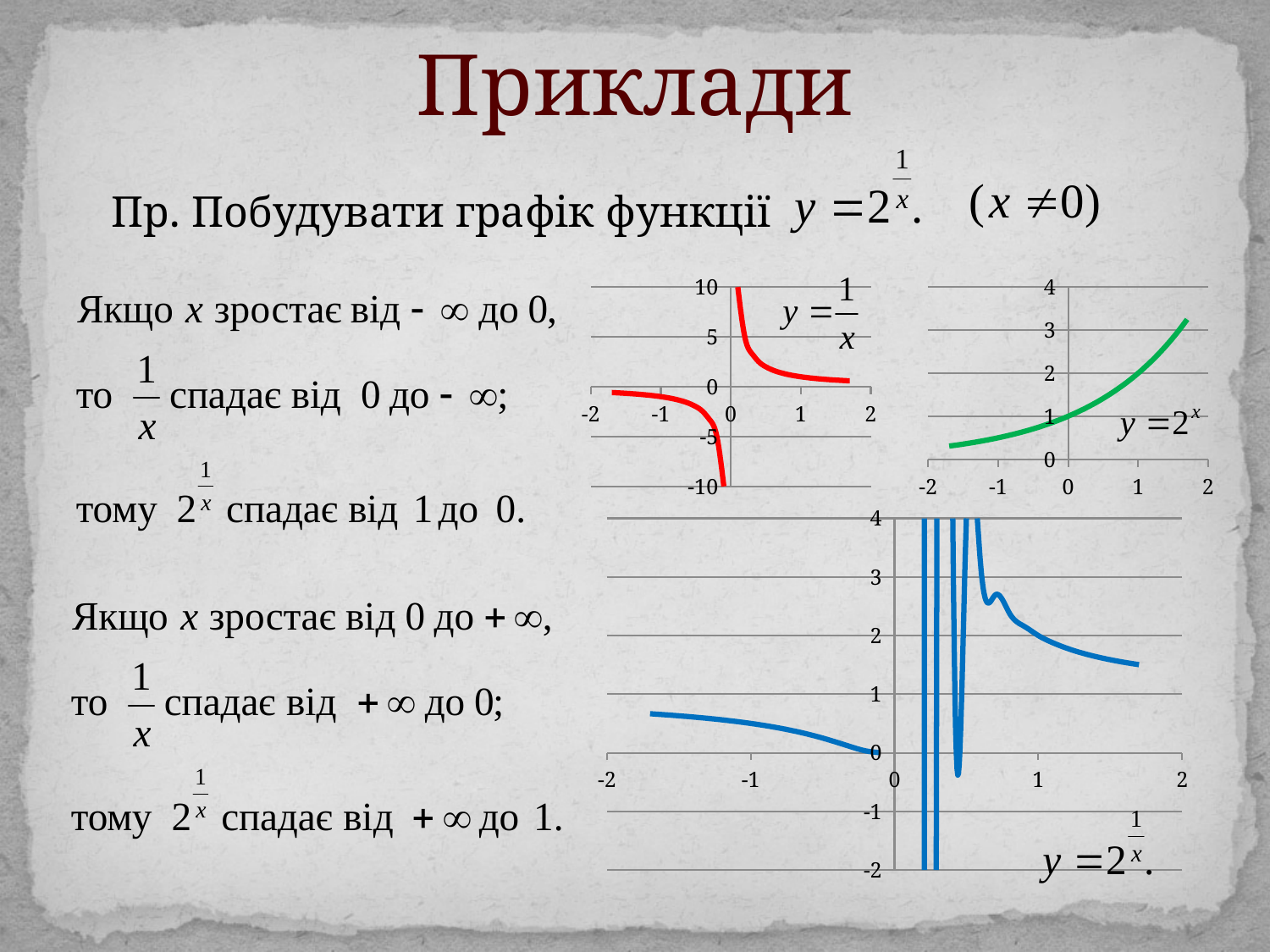
In the top-left chart y = 1/x, is the value at x = 1 greater or less than 5? less What kind of chart is the top-left chart labelled y = 1/x? line chart What colour is the curve in the top-right chart labelled y = 2^x? green In the bottom chart y = 2^(1/x), does the curve rise or fall as x increases from 1 to 2? falls In the top-left chart y = 1/x, does the curve rise or fall as x increases from -2 toward 0? falls In the top-right chart y = 2^x, is the value at x = -1 greater or less than 1? less What colour is the curve in the bottom chart labelled y = 2^(1/x)? blue In the top-right chart y = 2^x, does the curve rise or fall as x increases from -2 to 2? rises In the top-right chart y = 2^x, which is larger: the value at x = 1 or the value at x = -1? x = 1 In the bottom chart y = 2^(1/x), is the value at x = -1 greater or less than 1? less How many charts are shown on the slide? 3